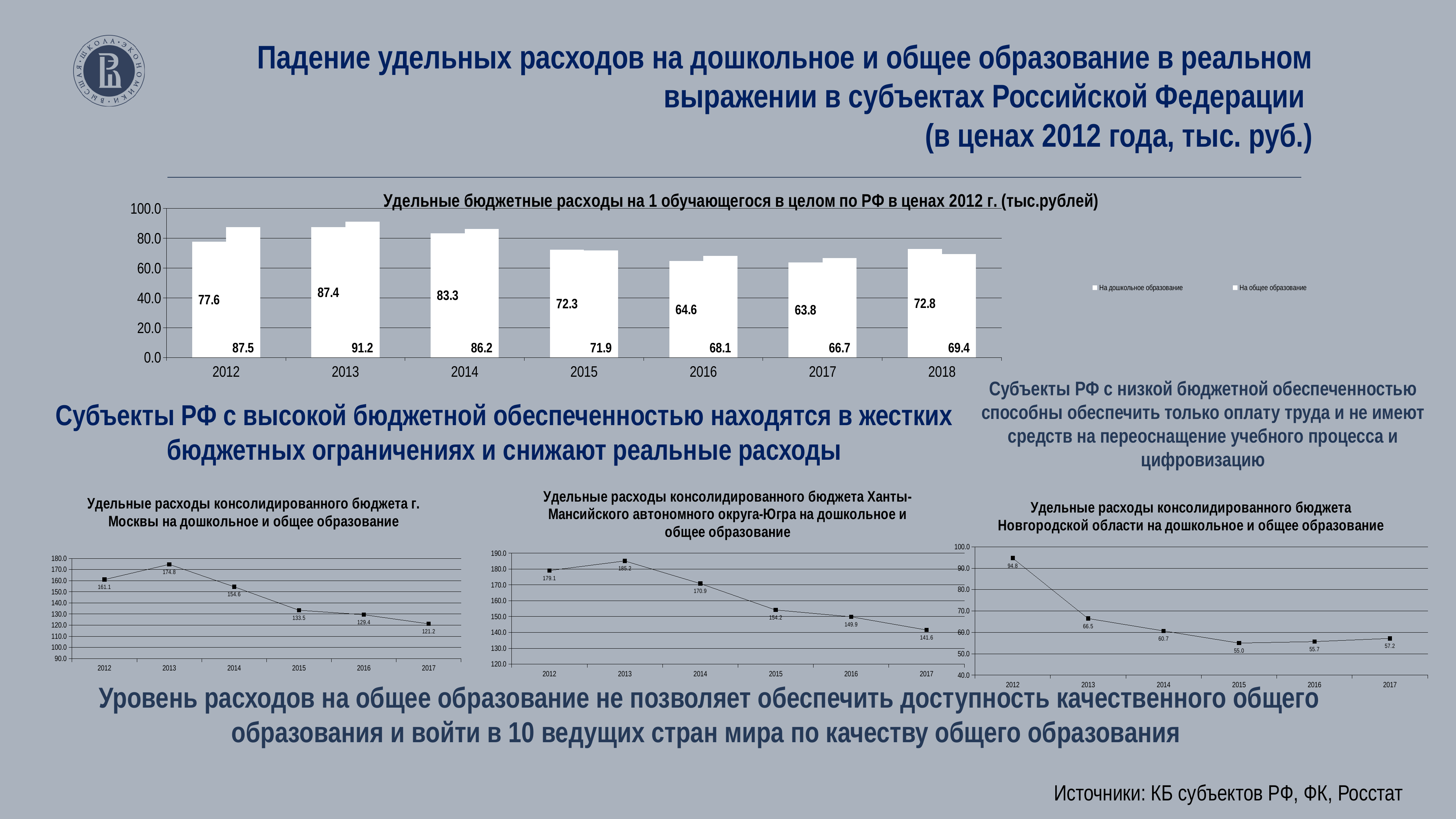
In the top bar chart 'Удельные бюджетные расходы на 1 обучающегося в целом по РФ', what is the value for 'На дошкольное образование' in 2013? 87.4 In the chart for Ханты-Мансийского автономного округа-Югра (bottom middle), which year has the highest value? 2013 In the top bar chart, which is larger in 2018: 'На дошкольное образование' or 'На общее образование'? На дошкольное образование In the top bar chart 'Удельные бюджетные расходы на 1 обучающегося в целом по РФ', what is the value for 'На общее образование' in 2017? 66.7 In the chart for г. Москвы (bottom left), what is the value for 2015? 133.5 In the top bar chart, what is the difference between the 'На общее образование' and 'На дошкольное образование' values in 2012? 9.9 How many years are plotted in the chart for Новгородской области (bottom right)? 6 In the top bar chart, which year has the lowest value for 'На дошкольное образование'? 2017 What kind of chart is the chart titled 'Удельные расходы консолидированного бюджета г. Москвы на дошкольное и общее образование'? line chart How many series does the legend of the top bar chart list? 2 In the top bar chart, which year has the highest value for 'На общее образование'? 2013 In the chart for Новгородской области (bottom right), what is the value for 2012? 94.8